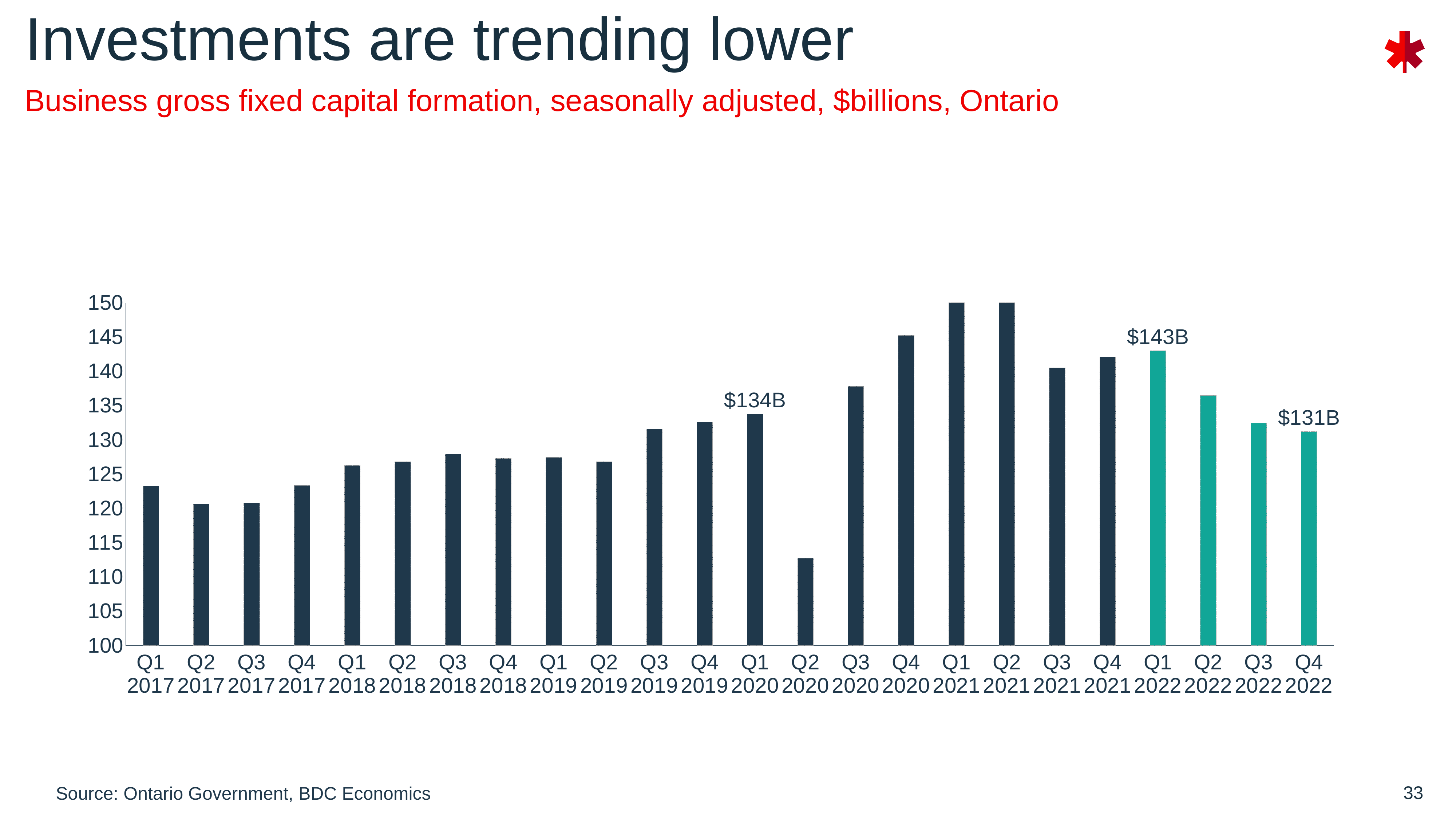
What is the value for Q4 2022? $131B What is the value for Q1 2022? $143B What is the difference between the values for Q1 2022 and Q4 2022? $12B Is the value for Q2 2020 greater or less than 115? less What is the value for Q1 2020? $134B Which quarter has the lowest value? Q2 2020 Which is larger, the value for Q2 2020 or the value for Q3 2020? Q3 2020 Do the values rise or fall across the four quarters of 2022? fall What is the difference between the values for Q1 2022 and Q1 2020? $9B Is the value for Q1 2021 greater or less than 145? greater How many quarters are plotted on the chart? 24 Is the value for Q1 2017 greater or less than 125? less